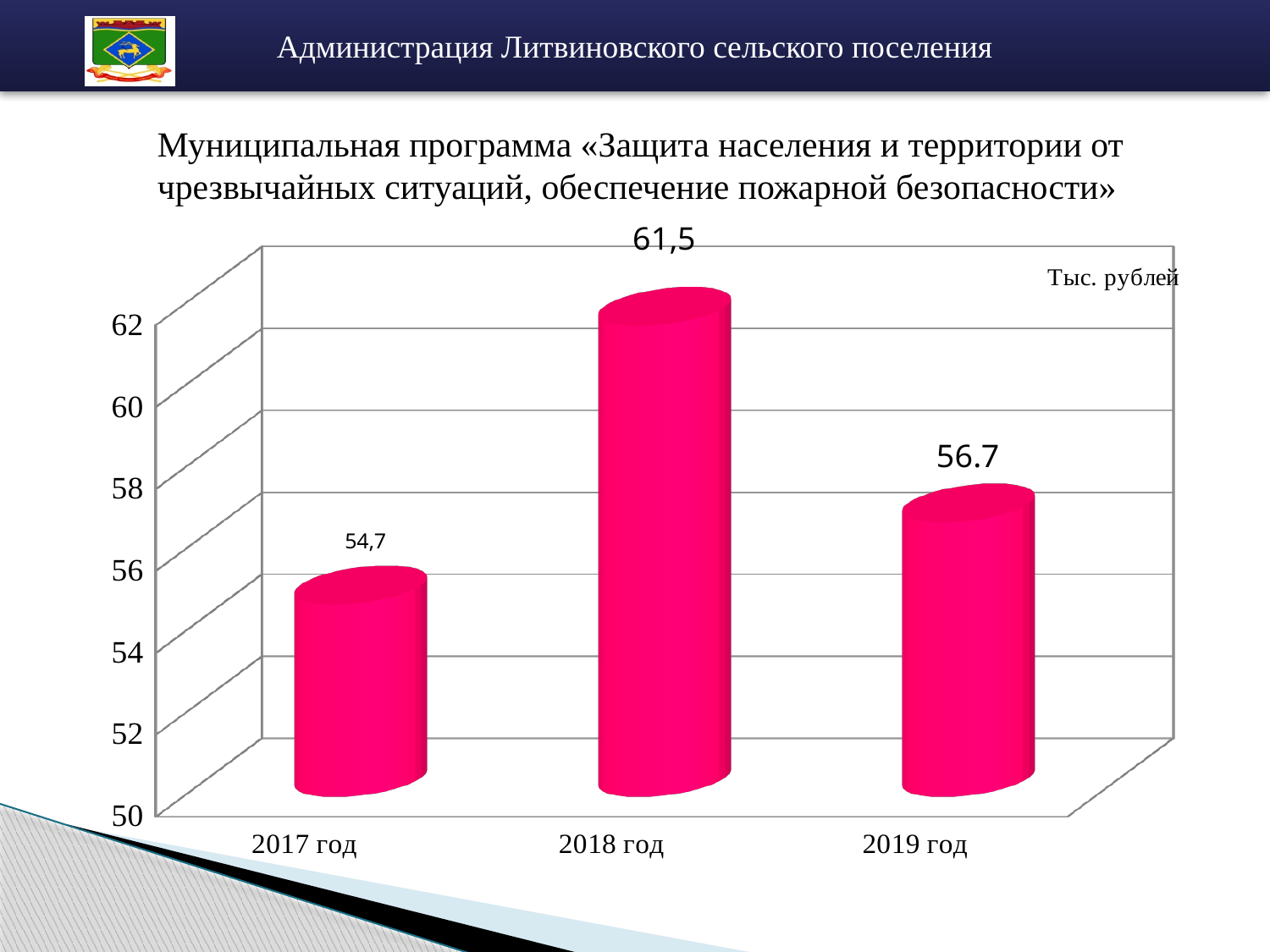
What is the difference between the values for 2018 год and 2017 год? 6,8 What is the value for 2018 год? 61,5 How many years are shown on the chart? 3 What is the value for 2017 год? 54,7 Which year has the lowest value? 2017 год Which is larger, the value for 2019 год or the value for 2017 год? 2019 год Which year has the highest value? 2018 год In what units are the chart values given, according to the label on the chart? Тыс. рублей Is the value for 2019 год greater or less than 58? less Is the value for 2018 год greater or less than 60? greater What kind of chart is shown on the slide? bar chart What is the value for 2019 год? 56.7